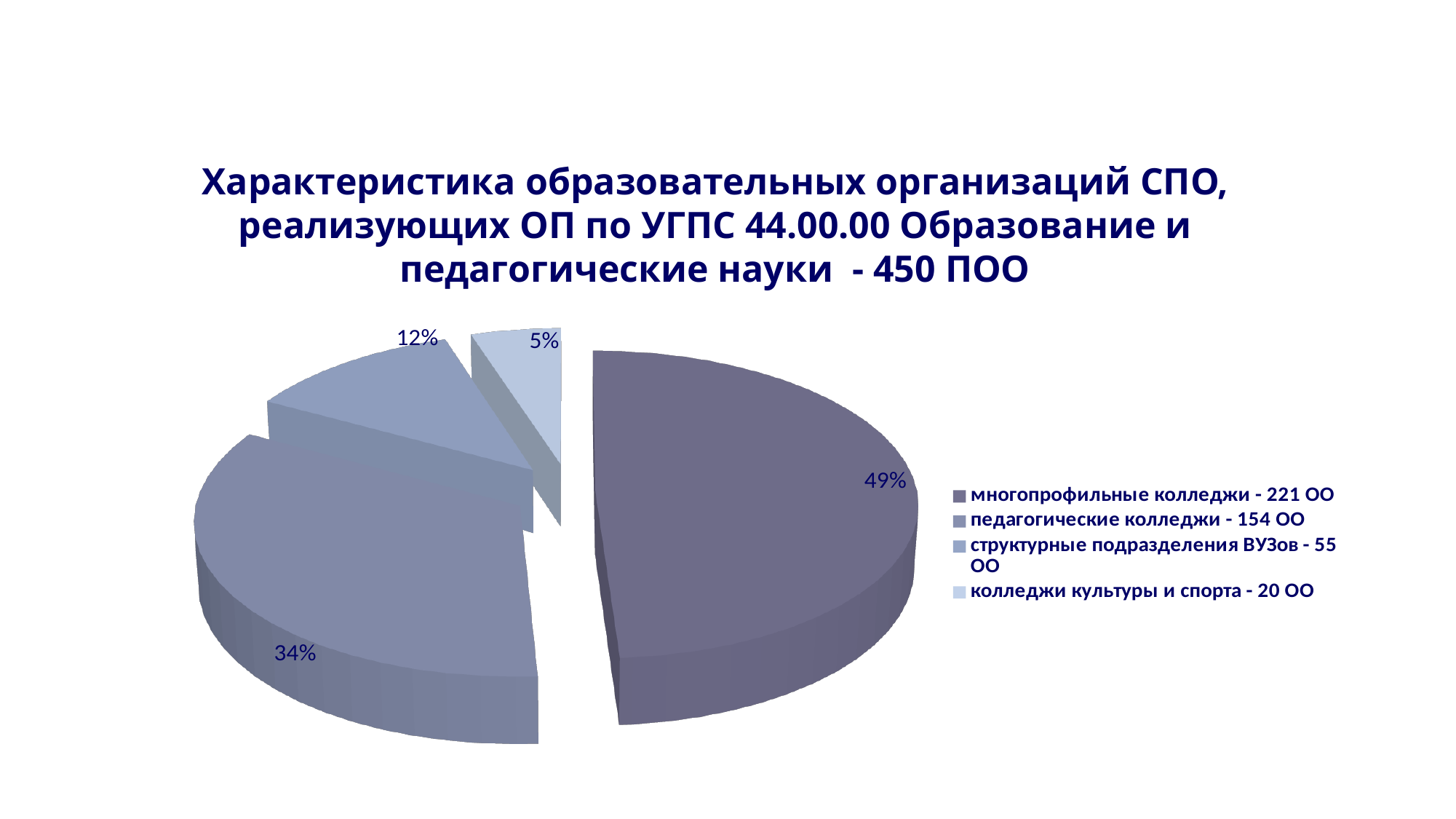
Which category has the largest slice of the pie? многопрофильные колледжи What share of the pie is labelled for педагогические колледжи? 34% What total number of ПОО is stated in the chart title? 450 ПОО What kind of chart is shown on the slide? Pie chart What is the difference in percentage points between the многопрофильные колледжи slice and the педагогические колледжи slice? 15% How many slices does the pie chart have? 4 Which slice is larger: структурные подразделения ВУЗов or колледжи культуры и спорта? структурные подразделения ВУЗов What share of the pie is labelled for колледжи культуры и спорта? 5% What share of the pie is labelled for многопрофильные колледжи? 49% Which category has the smallest slice of the pie? колледжи культуры и спорта According to the legend, how many organisations (ОО) are педагогические колледжи? 154 ОО